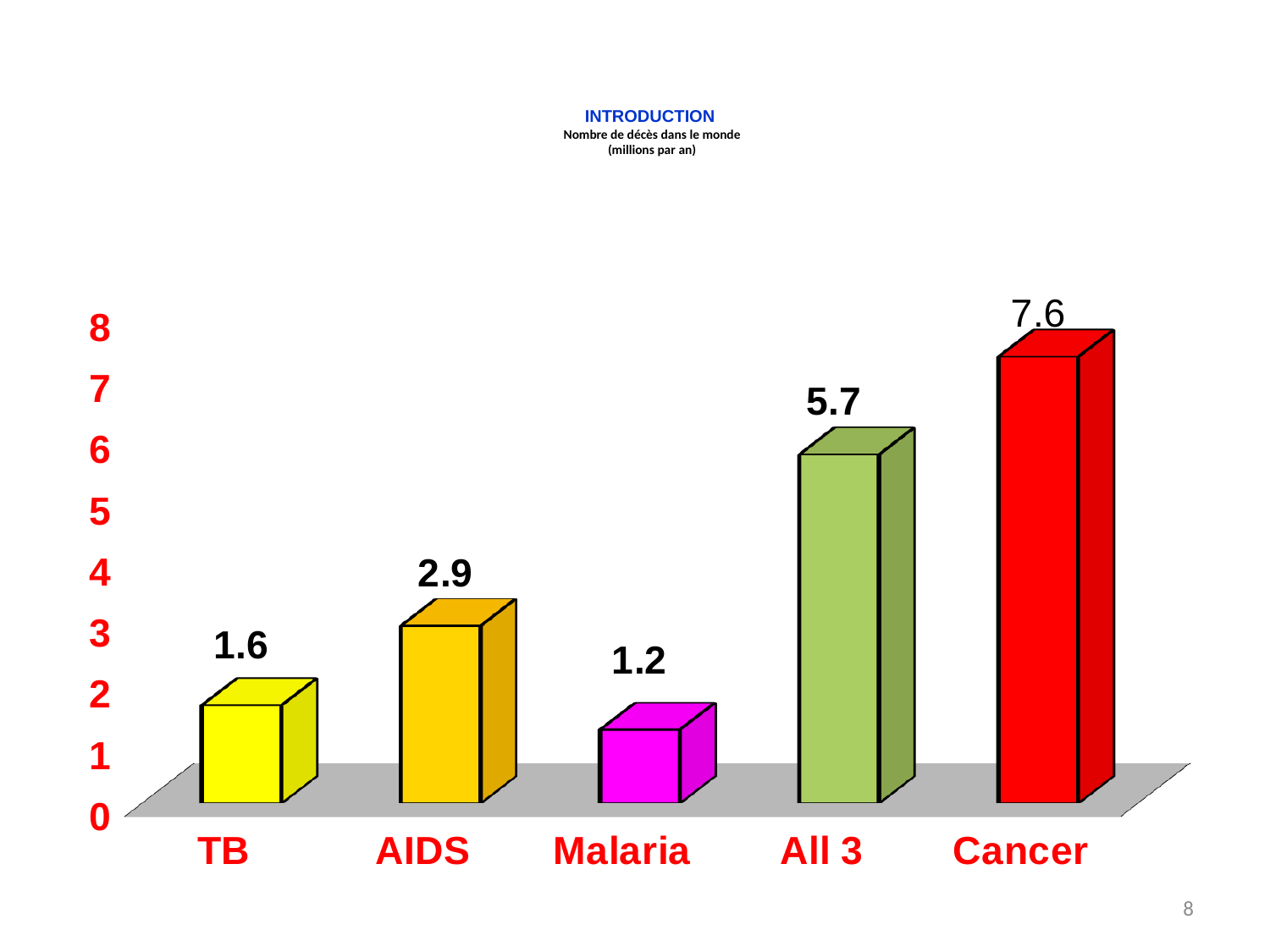
What is the value for AIDS? 2.9 What is the difference between the values for Cancer and All 3? 1.9 How many categories are shown on the x axis? 5 What is the value for Cancer? 7.6 What is the difference between the values for AIDS and TB? 1.3 Which is larger, the value for TB or the value for Malaria? TB Which category has the highest value? Cancer What unit is given in the chart's subtitle? millions par an Which category has the lowest value? Malaria What is the value for Malaria? 1.2 What kind of chart is shown on the slide? Bar chart What is the value for All 3? 5.7